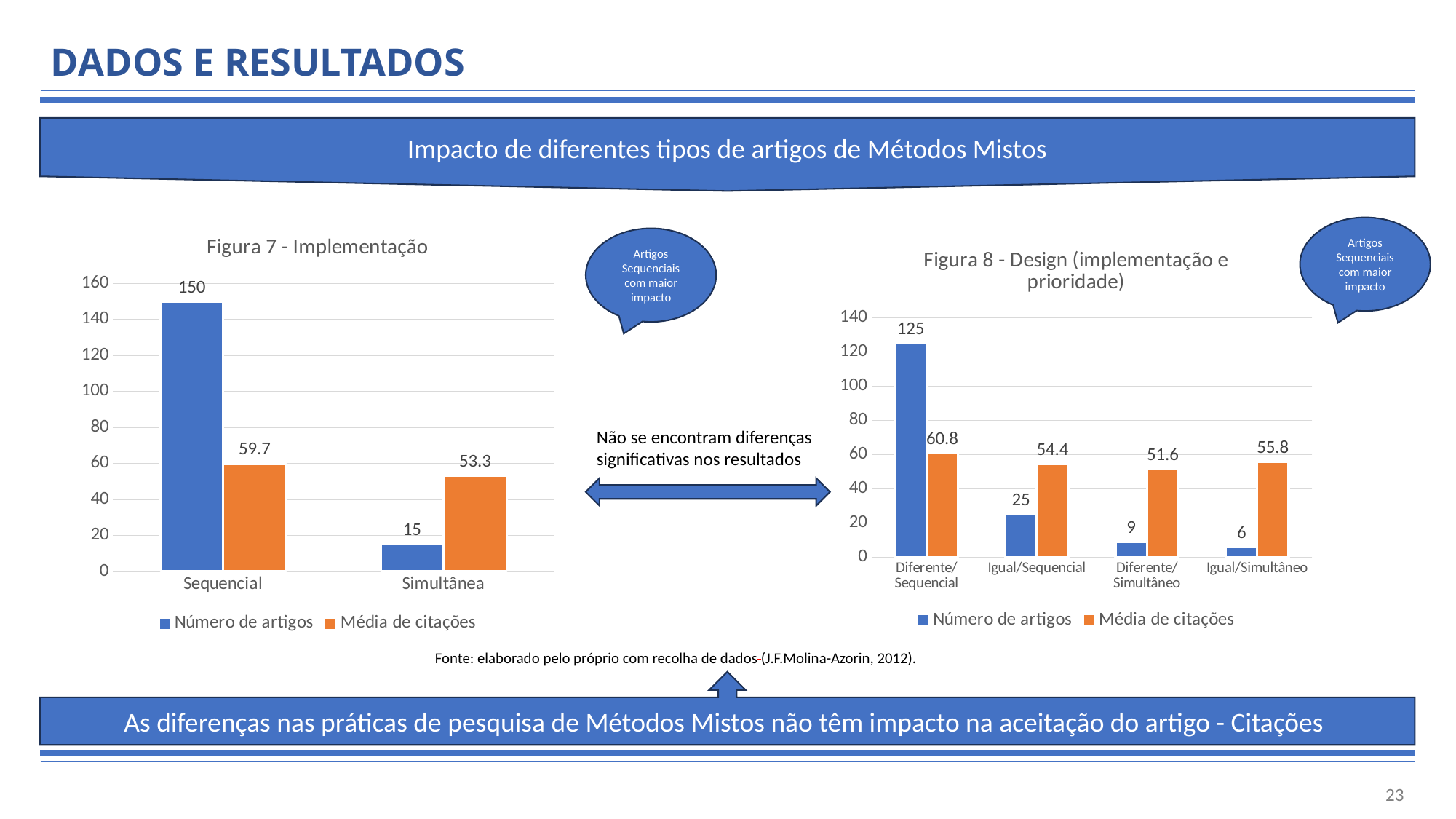
In the chart titled 'Figura 7 - Implementação', what is the difference between 'Número de artigos' for 'Sequencial' and for 'Simultânea'? 135 In the chart titled 'Figura 7 - Implementação', what is the value of 'Média de citações' for 'Simultânea'? 53.3 In the chart titled 'Figura 7 - Implementação', what kind of chart is it? Bar chart In the chart titled 'Figura 8 - Design (implementação e prioridade)', which category has the lowest 'Número de artigos'? Igual/Simultâneo In the chart titled 'Figura 8 - Design (implementação e prioridade)', what colour are the 'Média de citações' bars? Orange In the chart titled 'Figura 8 - Design (implementação e prioridade)', how many categories are shown on the x axis? 4 In the chart titled 'Figura 8 - Design (implementação e prioridade)', which category has the highest 'Média de citações'? Diferente/Sequencial In the chart titled 'Figura 7 - Implementação', how many series does the legend list? 2 In the chart titled 'Figura 8 - Design (implementação e prioridade)', what is the value of 'Média de citações' for 'Diferente/Simultâneo'? 51.6 In the chart titled 'Figura 8 - Design (implementação e prioridade)', is 'Média de citações' for 'Igual/Simultâneo' larger than for 'Igual/Sequencial'? Yes In the chart titled 'Figura 7 - Implementação', what is the value of 'Número de artigos' for 'Sequencial'? 150 In the chart titled 'Figura 8 - Design (implementação e prioridade)', what is the value of 'Número de artigos' for 'Igual/Sequencial'? 25